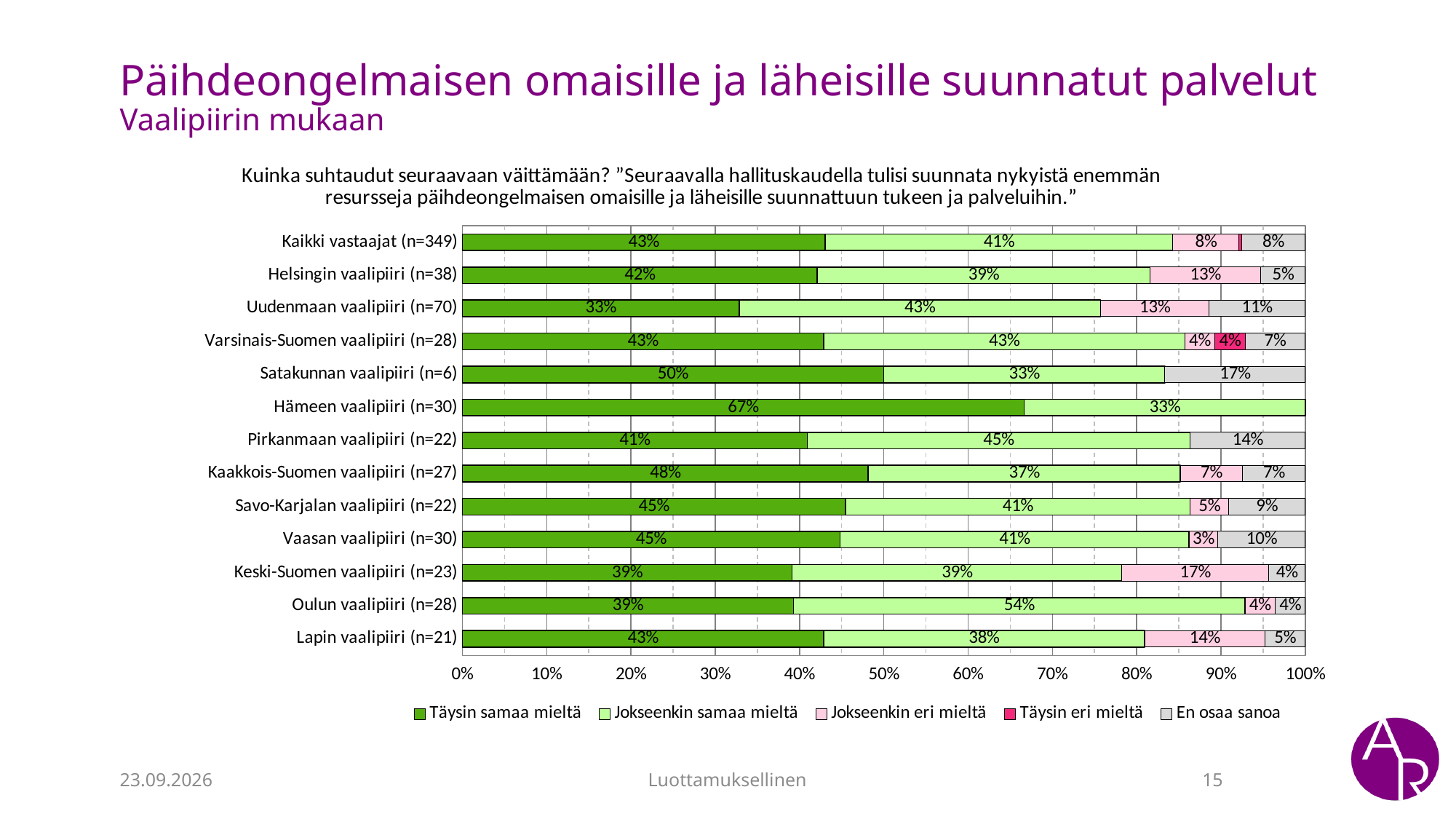
How many series does the legend list? 5 What is the 'Täysin samaa mieltä' value for Hämeen vaalipiiri (n=30)? 67% What kind of chart is shown on the slide? Stacked bar chart What is the 'Jokseenkin eri mieltä' value for Helsingin vaalipiiri (n=38)? 13% What is the 'Jokseenkin samaa mieltä' value for Oulun vaalipiiri (n=28)? 54% Which category has the highest 'Täysin samaa mieltä' share? Hämeen vaalipiiri (n=30) Which category has the highest 'Jokseenkin eri mieltä' share? Keski-Suomen vaalipiiri (n=23) Which is larger: the 'Jokseenkin samaa mieltä' value for Pirkanmaan vaalipiiri (n=22) or for Lapin vaalipiiri (n=21)? Pirkanmaan vaalipiiri (n=22) What is the 'En osaa sanoa' value for Satakunnan vaalipiiri (n=6)? 17% How many categories (rows) are plotted in the chart? 13 What is the difference between the 'Täysin samaa mieltä' values for Hämeen vaalipiiri (n=30) and Kaikki vastaajat (n=349)? 24 percentage points Which category has the lowest 'Täysin samaa mieltä' share? Uudenmaan vaalipiiri (n=70)